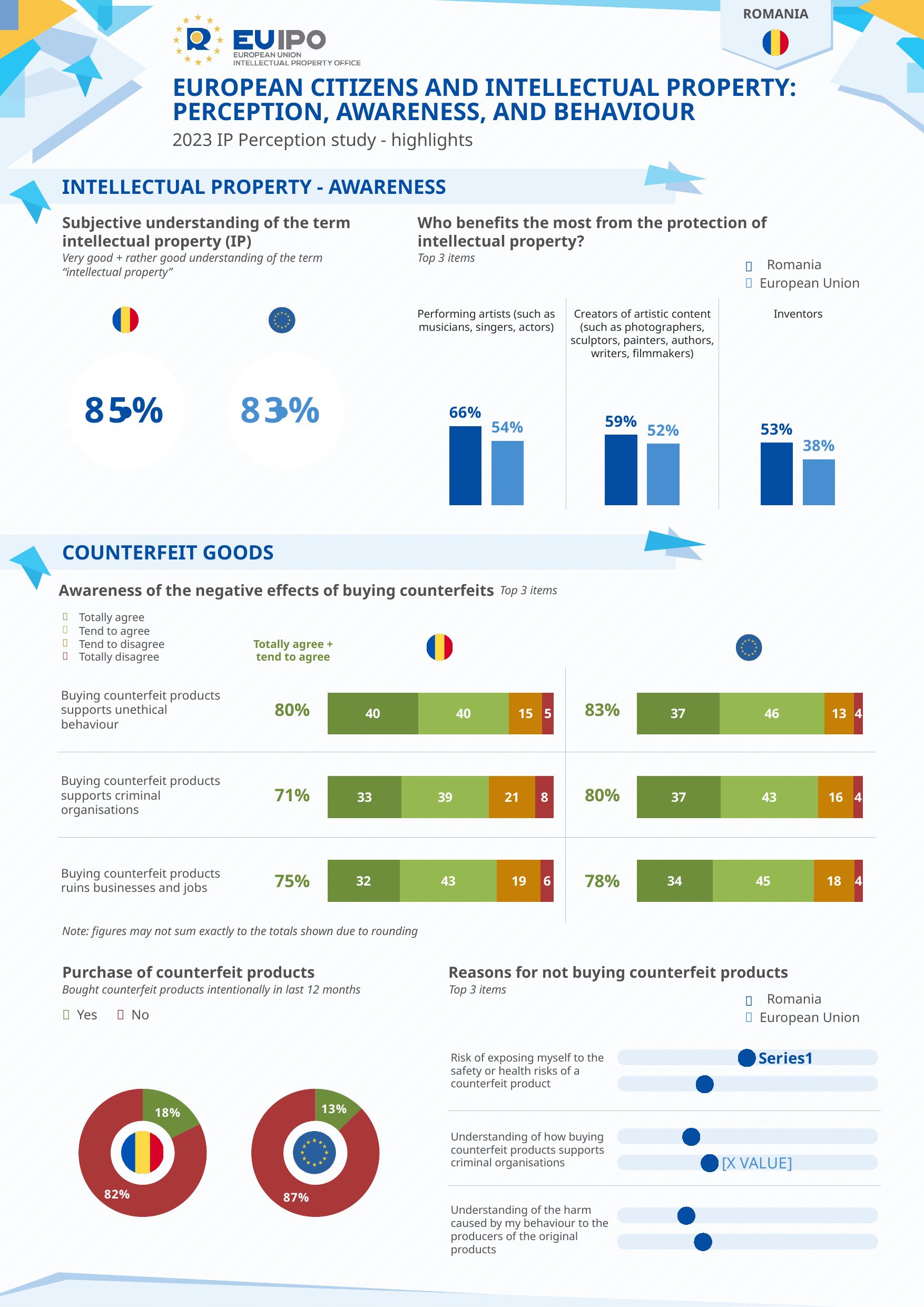
In the 'Who benefits the most from the protection of intellectual property?' chart, what is the European Union value for Inventors? 38% In the 'Awareness of the negative effects of buying counterfeits' chart, what is the Romania 'Totally agree' value for 'Buying counterfeit products supports criminal organisations'? 33 In the 'Who benefits the most from the protection of intellectual property?' chart, what is the Romania value for Performing artists? 66% In the 'Who benefits the most from the protection of intellectual property?' chart, which category has the lowest European Union value? Inventors In the 'Awareness of the negative effects of buying counterfeits' chart, how many response categories does the legend list? 4 In the 'Purchase of counterfeit products' chart, what share of Romania respondents answered Yes? 18% In the 'Purchase of counterfeit products' chart, what is the European Union value for No? 87% In the 'Awareness of the negative effects of buying counterfeits' chart, which is larger: the Romania 'Totally agree + tend to agree' total for 'supports unethical behaviour' or for 'supports criminal organisations'? Supports unethical behaviour In the 'Who benefits the most from the protection of intellectual property?' chart, what is the difference between the Romania and European Union values for Inventors? 15% What kind of chart is used for 'Who benefits the most from the protection of intellectual property?' Bar chart In the 'Awareness of the negative effects of buying counterfeits' chart, what is the European Union 'Tend to agree' value for 'Buying counterfeit products ruins businesses and jobs'? 45 In the 'Who benefits the most from the protection of intellectual property?' chart, how many series does the legend list? 2